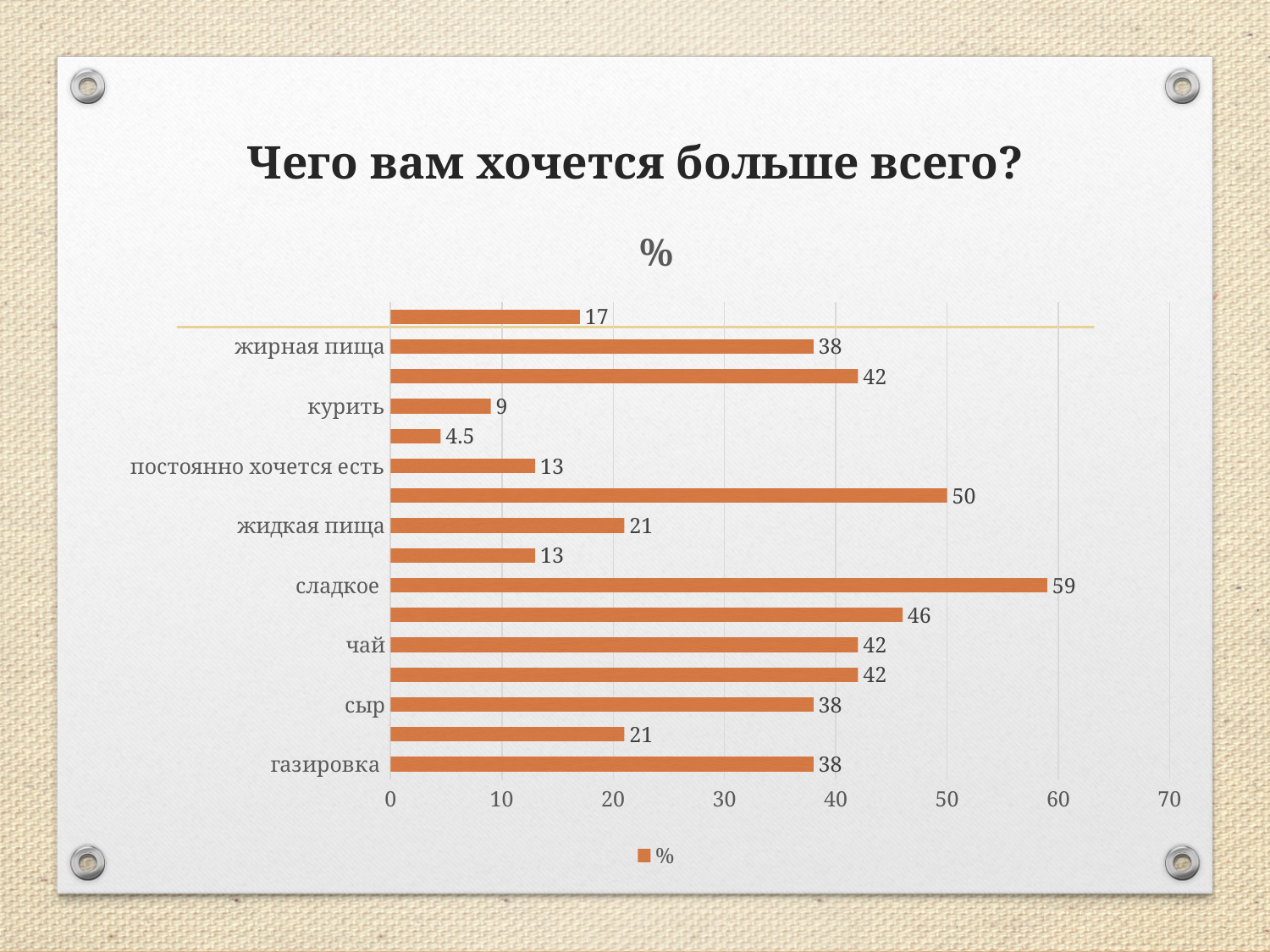
What is the smallest value shown on the chart? 4.5 What is the difference between the values for сладкое and сыр? 21 Which is larger, the value for чай or the value for газировка? чай How many series does the legend list? 1 Which labeled category has the highest value? сладкое What is the value for чай? 42 What is the title of the slide? Чего вам хочется больше всего? How many bars are plotted on the chart? 16 What type of chart is shown on the slide? bar chart What is the value for жидкая пища? 21 What is the value for сладкое? 59 What is the value for курить? 9